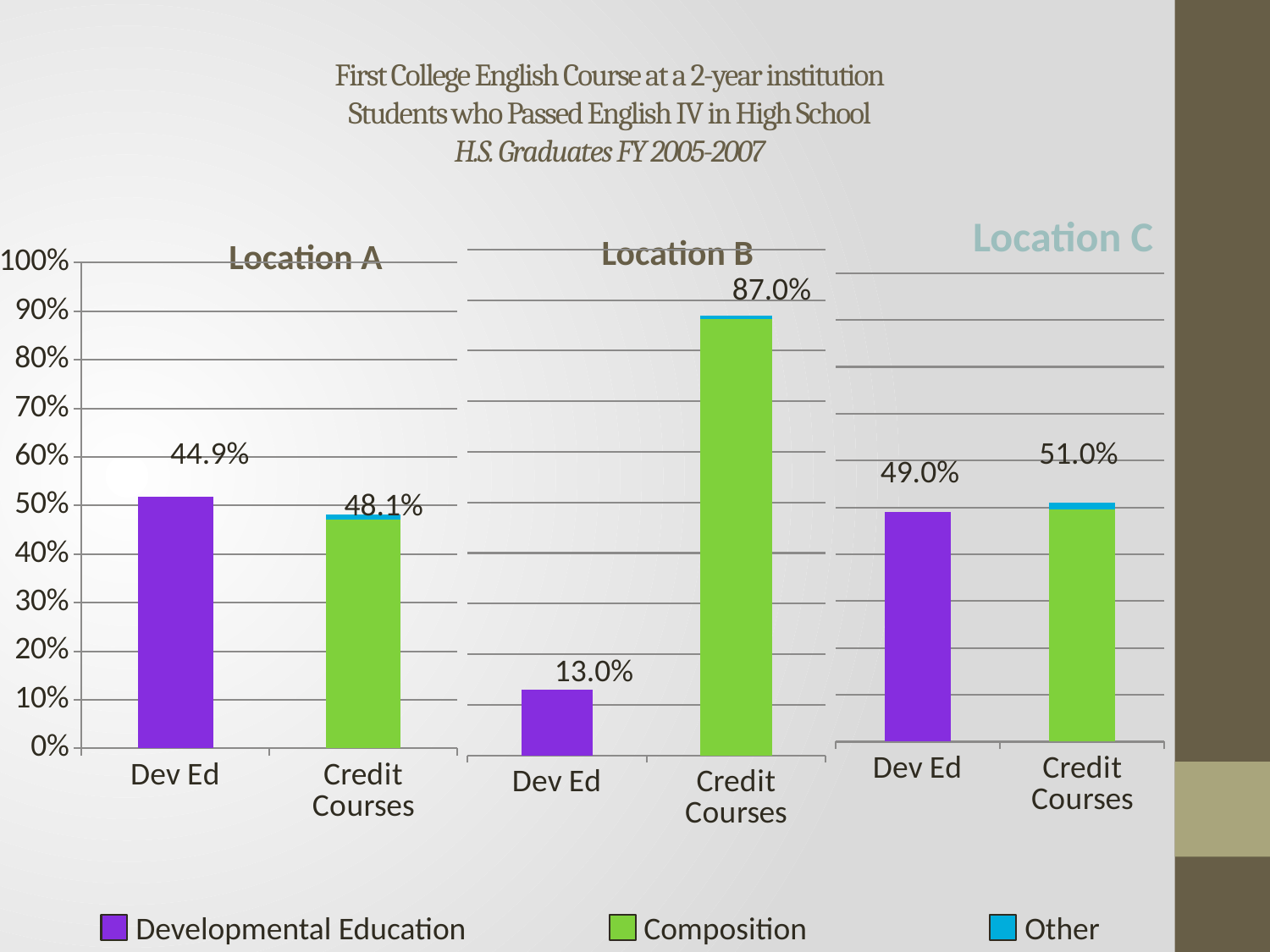
In the Location C chart, what is the difference between the Credit Courses value and the Dev Ed value? 2.0% In the Location B chart, what is the value labelled for Dev Ed? 13.0% What kind of chart is used for Location A? Bar chart In the Location B chart, is the value for Dev Ed greater or less than 20%? less In the Location B chart, which category has the higher value, Dev Ed or Credit Courses? Credit Courses In the Location B chart, what is the difference between the Credit Courses value and the Dev Ed value? 74.0% In the Location C chart, what is the value labelled for Credit Courses? 51.0% How many series does the legend at the bottom of the slide list? 3 In the Location B chart, what is the value labelled for Credit Courses? 87.0% In the Location A chart, what is the value labelled for Credit Courses? 48.1% In the Location C chart, what is the value labelled for Dev Ed? 49.0% How many categories are shown on the x axis of the Location C chart? 2